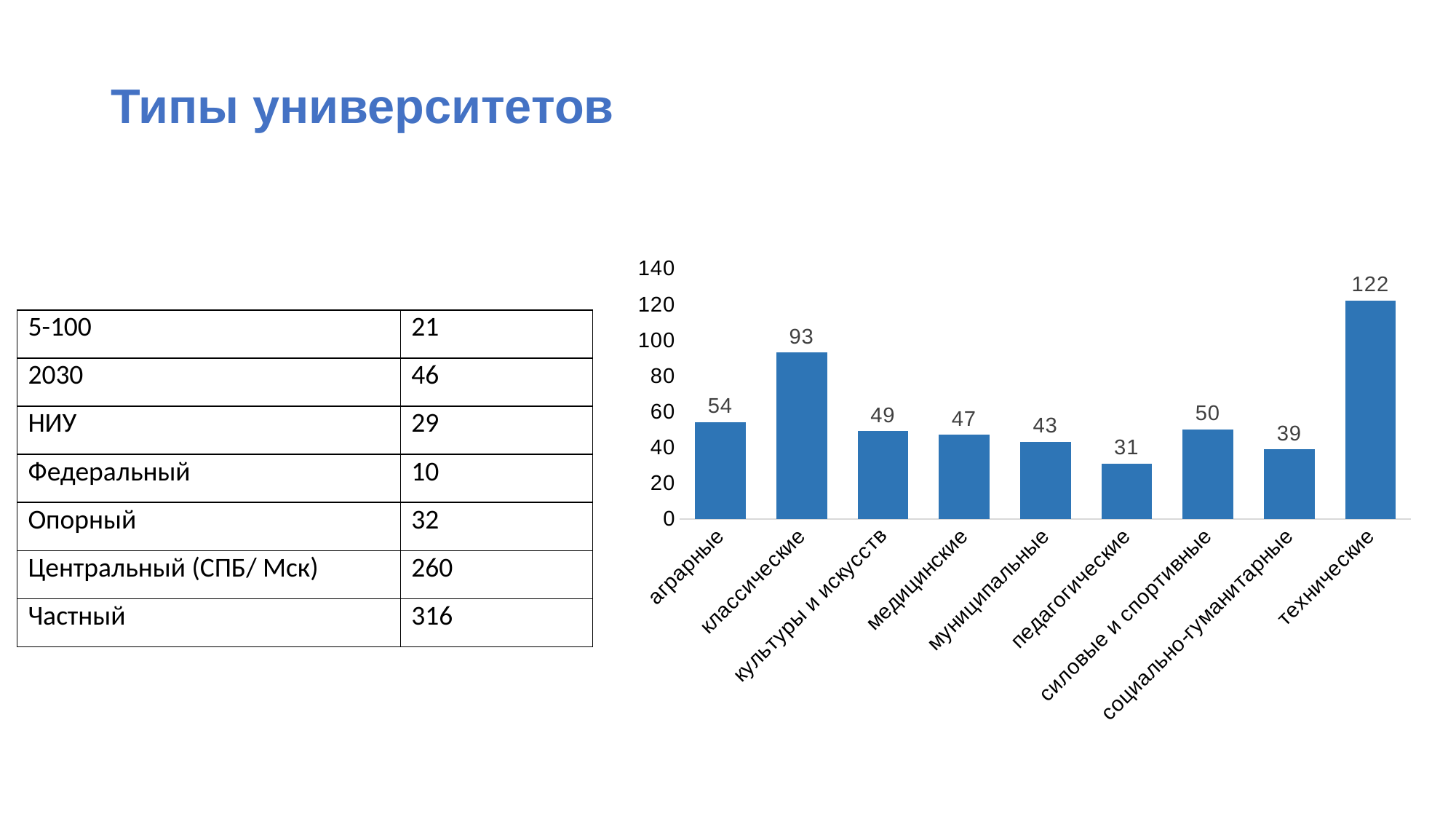
Which is larger, the value for аграрные or the value for муниципальные? аграрные What is the value for технические? 122 What is the difference between the values for медицинские and муниципальные? 4 Which category has the lowest value? педагогические What is the value for социально-гуманитарные? 39 Is the value for классические greater or less than 80? greater What kind of chart is shown on the slide? bar chart Which category has the highest value? технические What is the difference between the values for технические and классические? 29 What is the value for педагогические? 31 How many categories are shown on the x axis? 9 What is the value for классические? 93